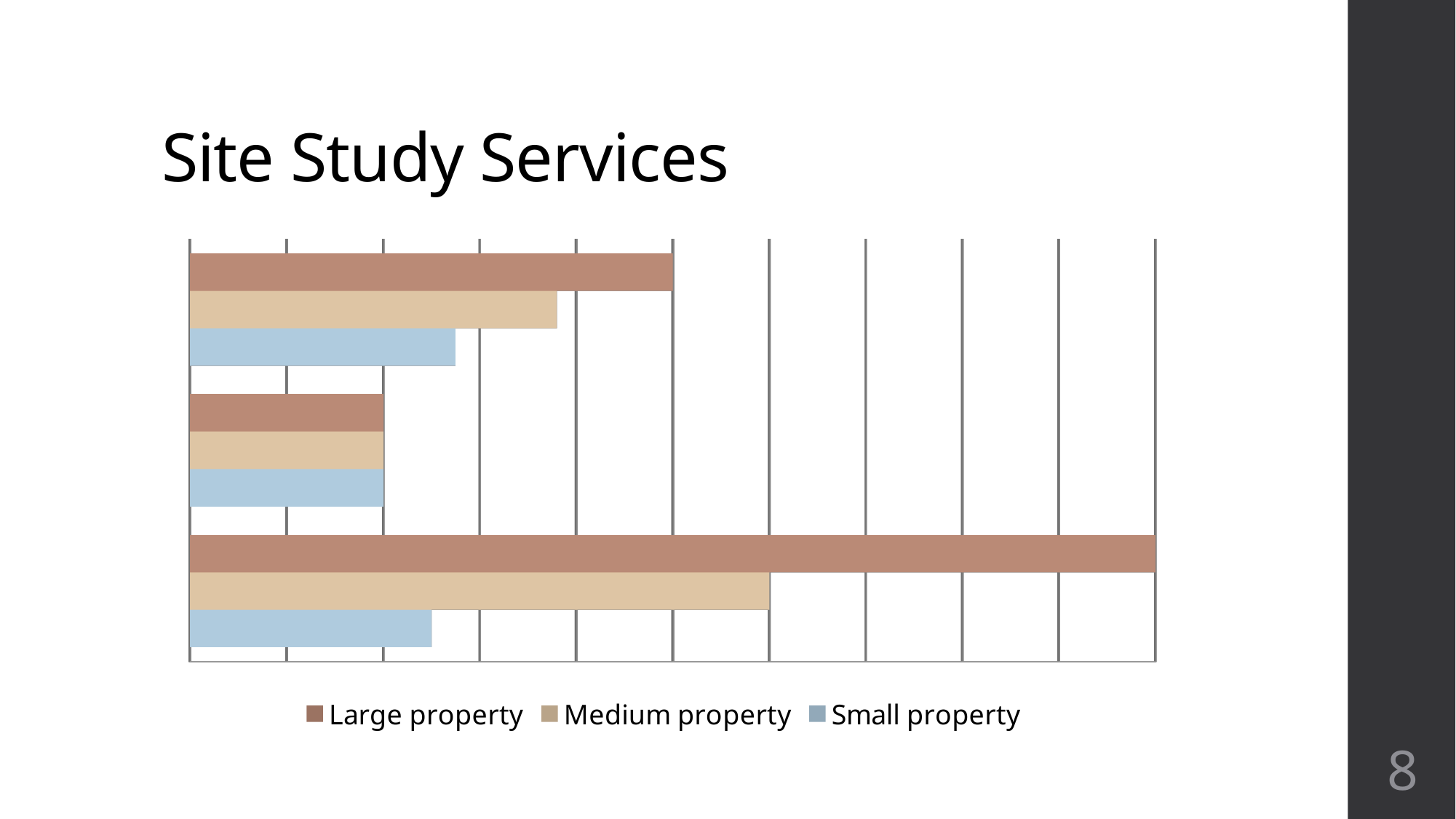
What kind of chart is shown on the slide? bar chart Is the longest bar in the chart from the Large property series or the Small property series? Large property Which series is listed first in the legend? Large property Which series is shown in light blue? Small property How many series does the legend list? 3 How many groups of bars (categories) are plotted in the chart? 3 Which series has the single longest bar in the chart? Large property Are the bars in the chart drawn horizontally or vertically? horizontally